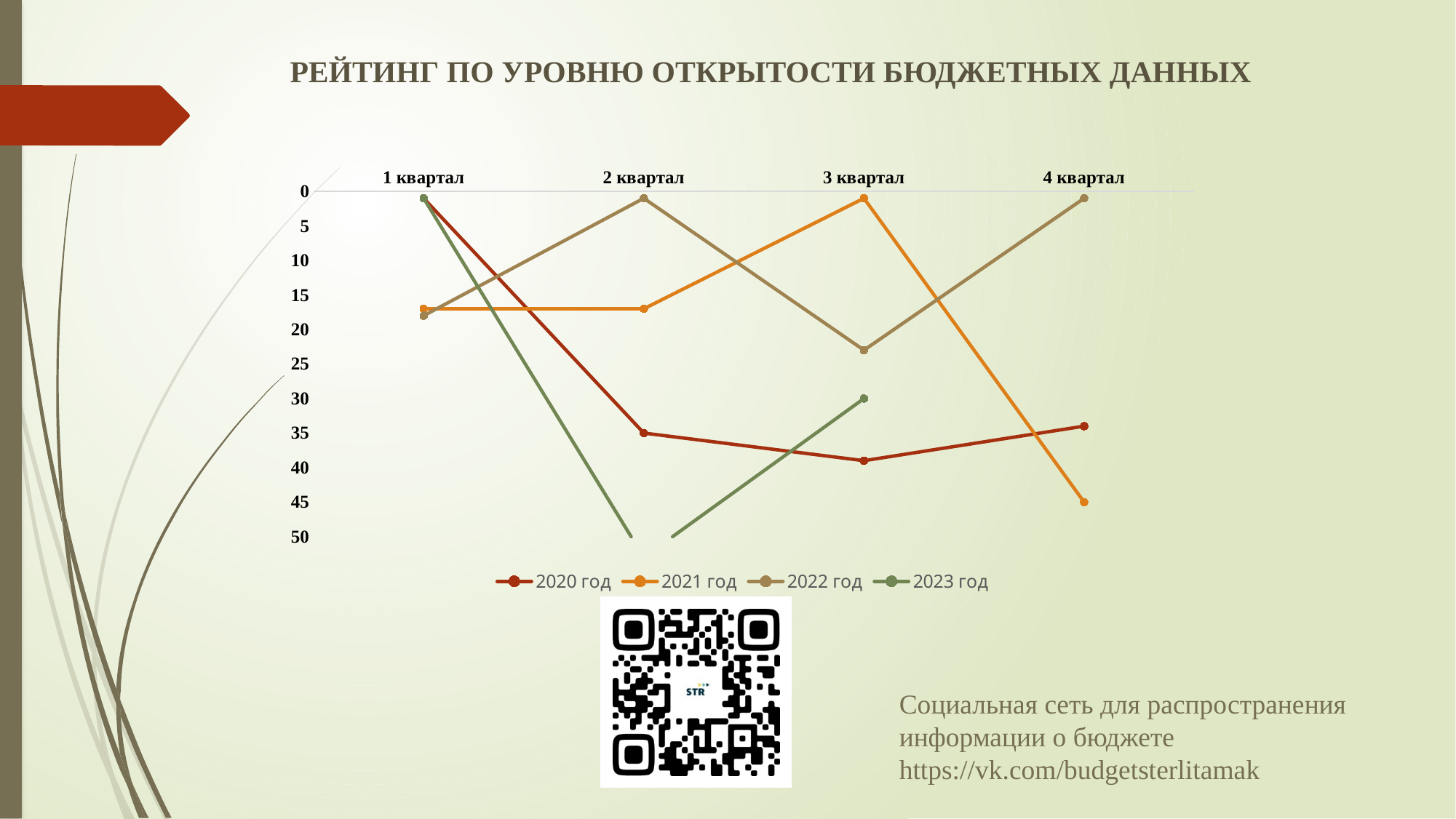
Is the value for 2020 год in 2 квартал greater or less than 30? greater Which series are listed in the legend? 2020 год, 2021 год, 2022 год, 2023 год What is the title of the chart? РЕЙТИНГ ПО УРОВНЮ ОТКРЫТОСТИ БЮДЖЕТНЫХ ДАННЫХ What kind of chart is shown on the slide? line chart How many quarters (categories) are shown on the x axis? 4 Is the value for 2021 год in 4 квартал greater or less than 40? greater Is the value for 2023 год in 3 квартал greater or less than 25? greater How many series does the legend list? 4 In 4 квартал, which series has the larger value: 2020 год or 2021 год? 2021 год Does the value for 2020 год increase or decrease from 1 квартал to 2 квартал? increase